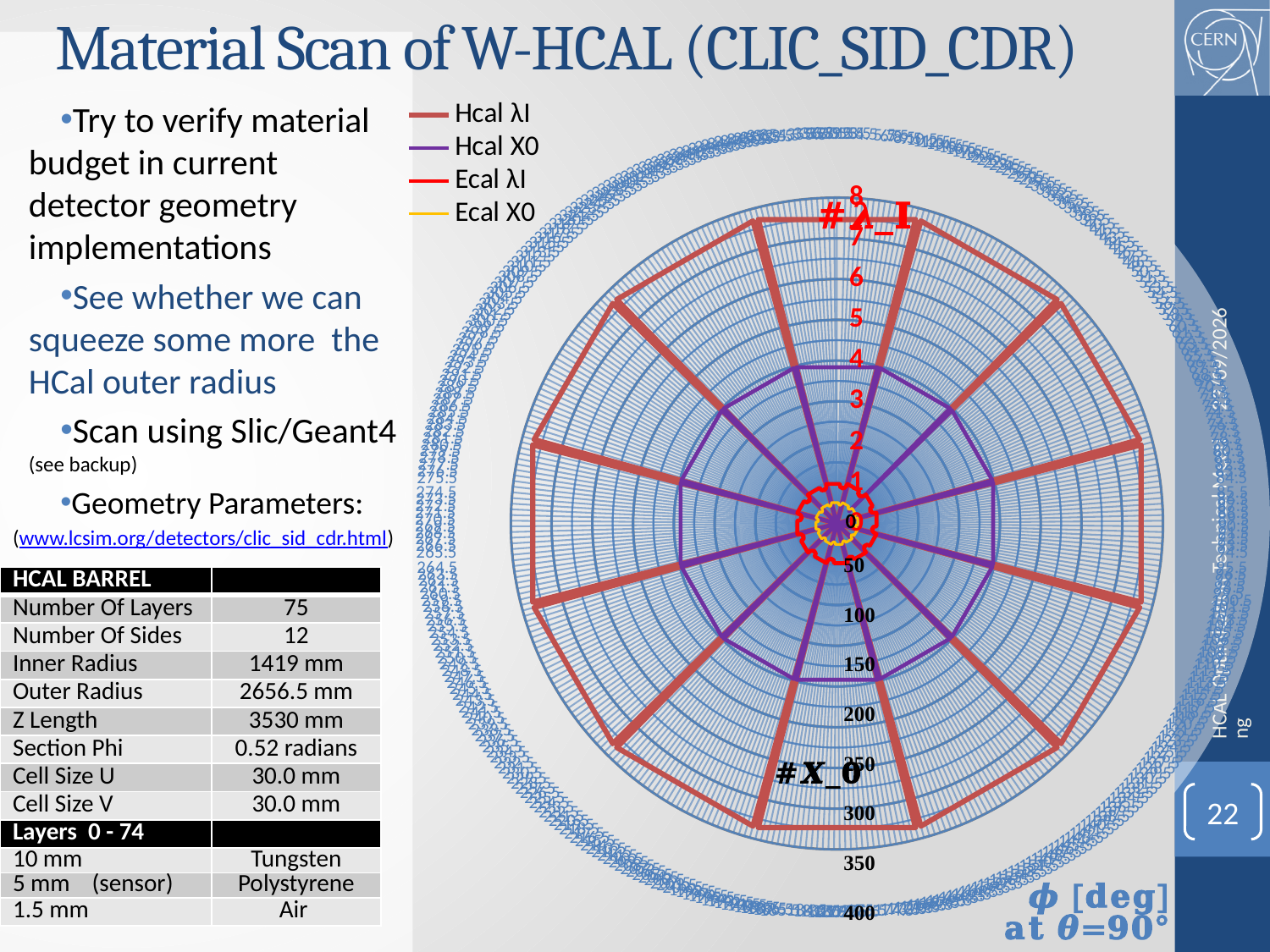
Which series has larger values in the chart, Hcal λI or Ecal λI? Hcal λI What is the angular axis label of the chart? φ [deg] at θ=90° How many series does the chart legend list? 4 Which series has the smallest values in the chart? Ecal X0 Which series has the largest values in the chart? Hcal λI How many sides does the Hcal λI polygon in the chart have? 12 Which series has larger values in the chart, Hcal X0 or Ecal X0? Hcal X0 What kind of chart is shown on the slide? radar chart Is the value of Hcal λI at the top of the chart greater or less than 6? greater Which series is drawn in purple in the chart? Hcal X0 Is the value of Ecal λI greater or less than 2 on the λI scale? less